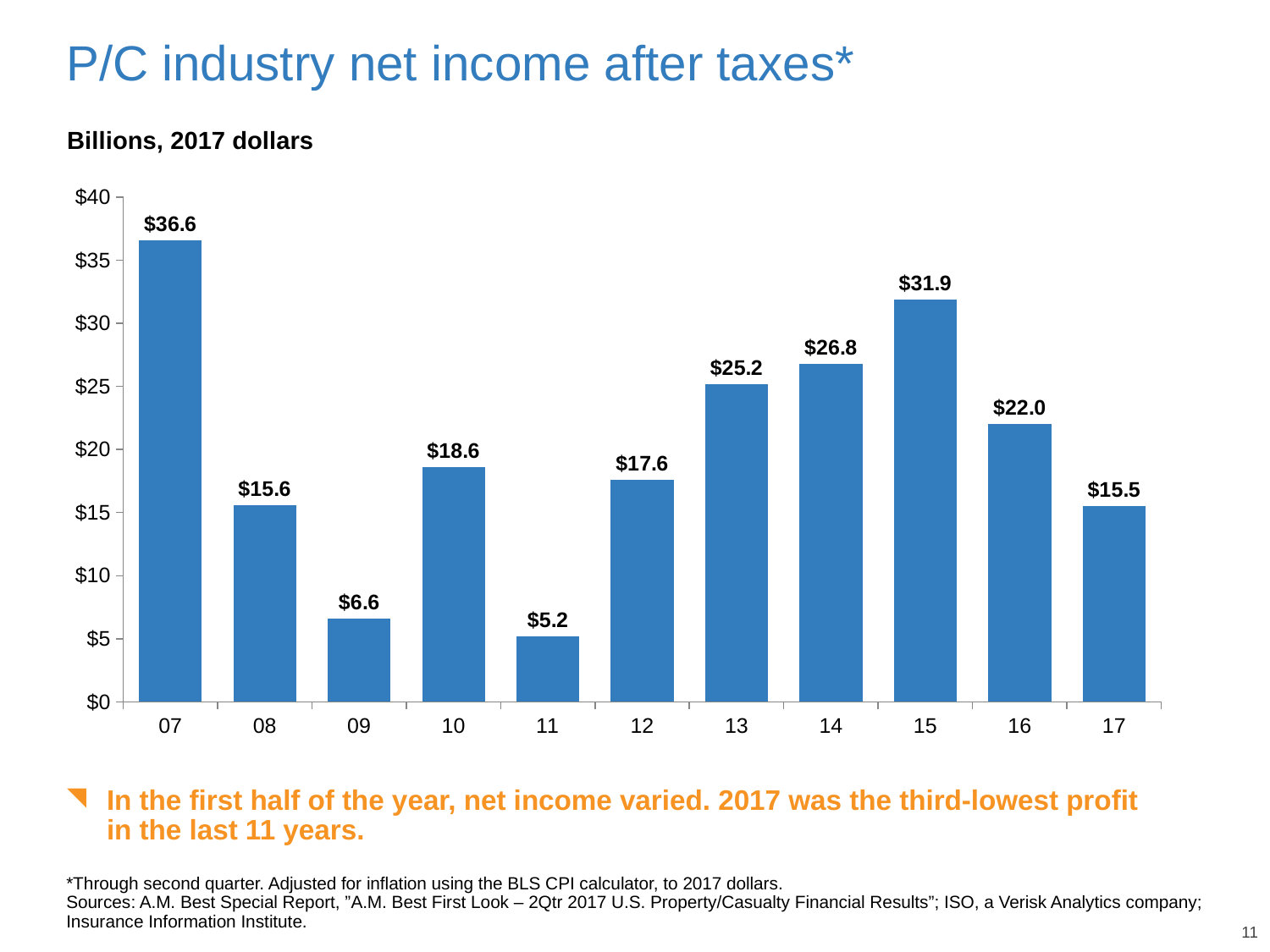
Do the values rise or fall from 2011 to 2015? rise What is the value shown for 2011? $5.2 Is the value for 2010 greater or less than $20? less What is the P/C industry net income after taxes for 2007? $36.6 What is the value shown for 2017? $15.5 What unit is stated for the values in the chart? Billions, 2017 dollars Which year has the larger value, 2013 or 2014? 14 How many years are shown on the x axis? 11 Which year has the lowest net income after taxes? 11 What kind of chart is shown on the slide? bar chart What is the difference between the values for 2015 and 2016? $9.9 Which year has the highest net income after taxes? 07